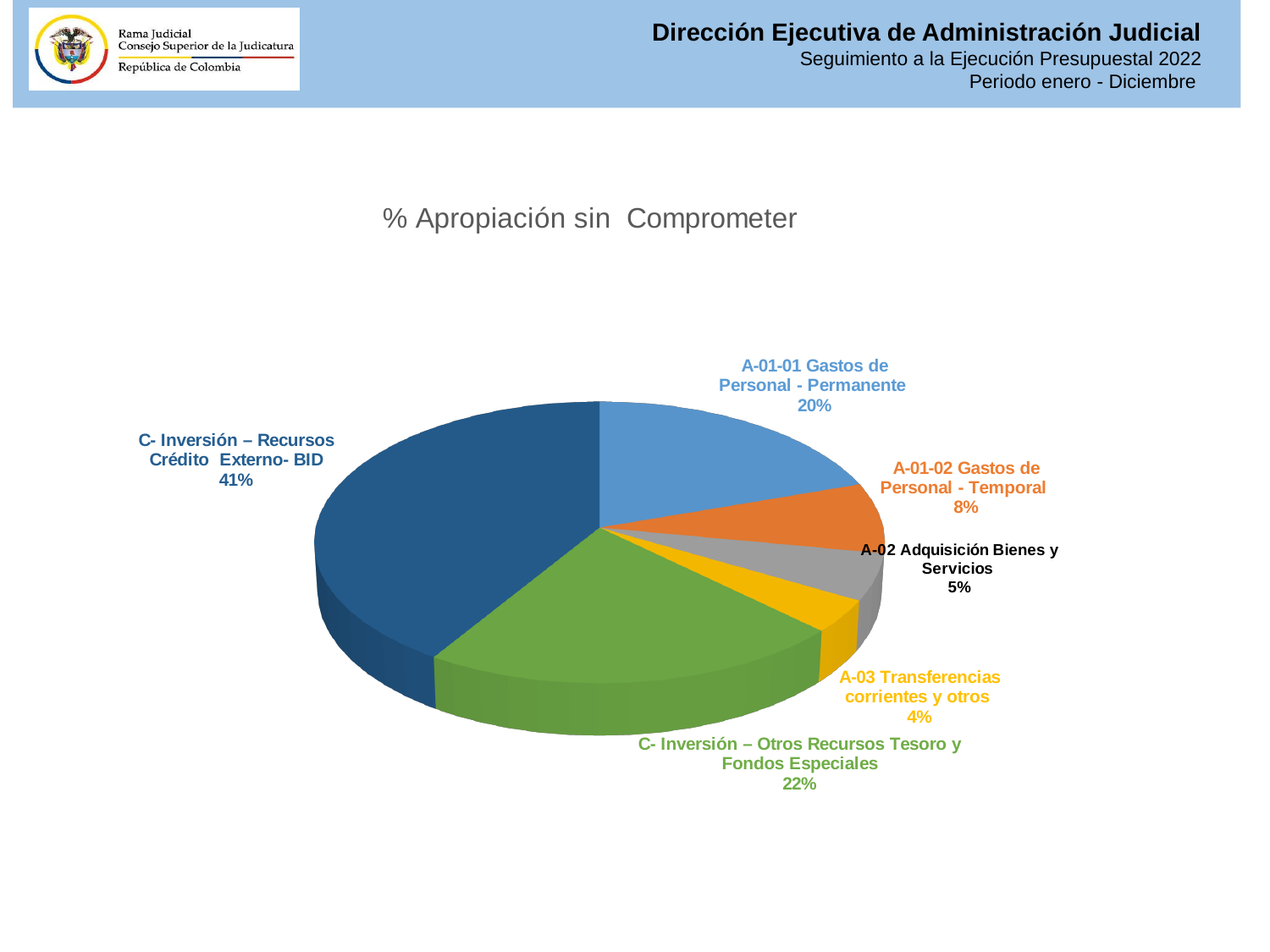
What is the title of the chart? % Apropiación sin Comprometer What share does the slice for A-02 Adquisición Bienes y Servicios have? 5% Which category has the largest slice of the pie? C- Inversión – Recursos Crédito Externo- BID Which category has the smallest slice of the pie? A-03 Transferencias corrientes y otros What share does the slice for A-01-01 Gastos de Personal - Permanente have? 20% What share does the slice for A-03 Transferencias corrientes y otros have? 4% Which is larger, the slice for A-01-01 Gastos de Personal - Permanente or the slice for A-01-02 Gastos de Personal - Temporal? A-01-01 Gastos de Personal - Permanente What is the difference in percentage points between C- Inversión – Recursos Crédito Externo- BID and C- Inversión – Otros Recursos Tesoro y Fondos Especiales? 19 percentage points What type of chart is shown on the slide? Pie chart How many slices does the pie chart have? 6